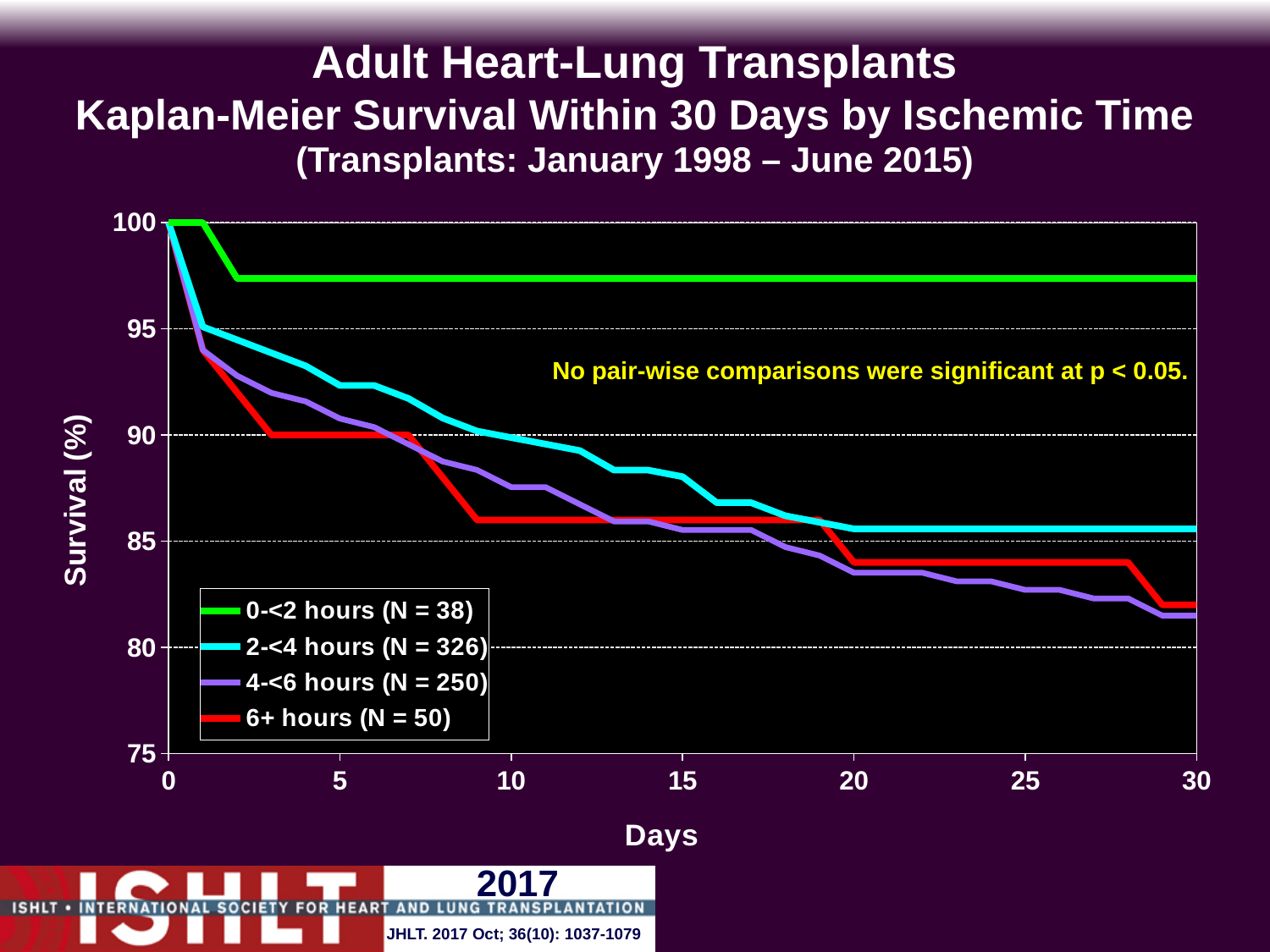
What kind of chart is shown on the slide? line chart At day 25, which group has higher survival: 2-<4 hours or 4-<6 hours? 2-<4 hours Is the survival for the 2-<4 hours group at day 30 greater or less than 90? less Is the survival for the 4-<6 hours group at day 30 greater or less than 85? less According to the legend, what is N for the 2-<4 hours group? 326 Do the survival curves rise or fall as days increase? fall At day 15, which group has higher survival: 2-<4 hours or 6+ hours? 2-<4 hours Which ischemic time group has the highest survival at day 30? 0-<2 hours How many series does the legend list? 4 Is the survival for the 6+ hours group at day 30 greater or less than 85? less